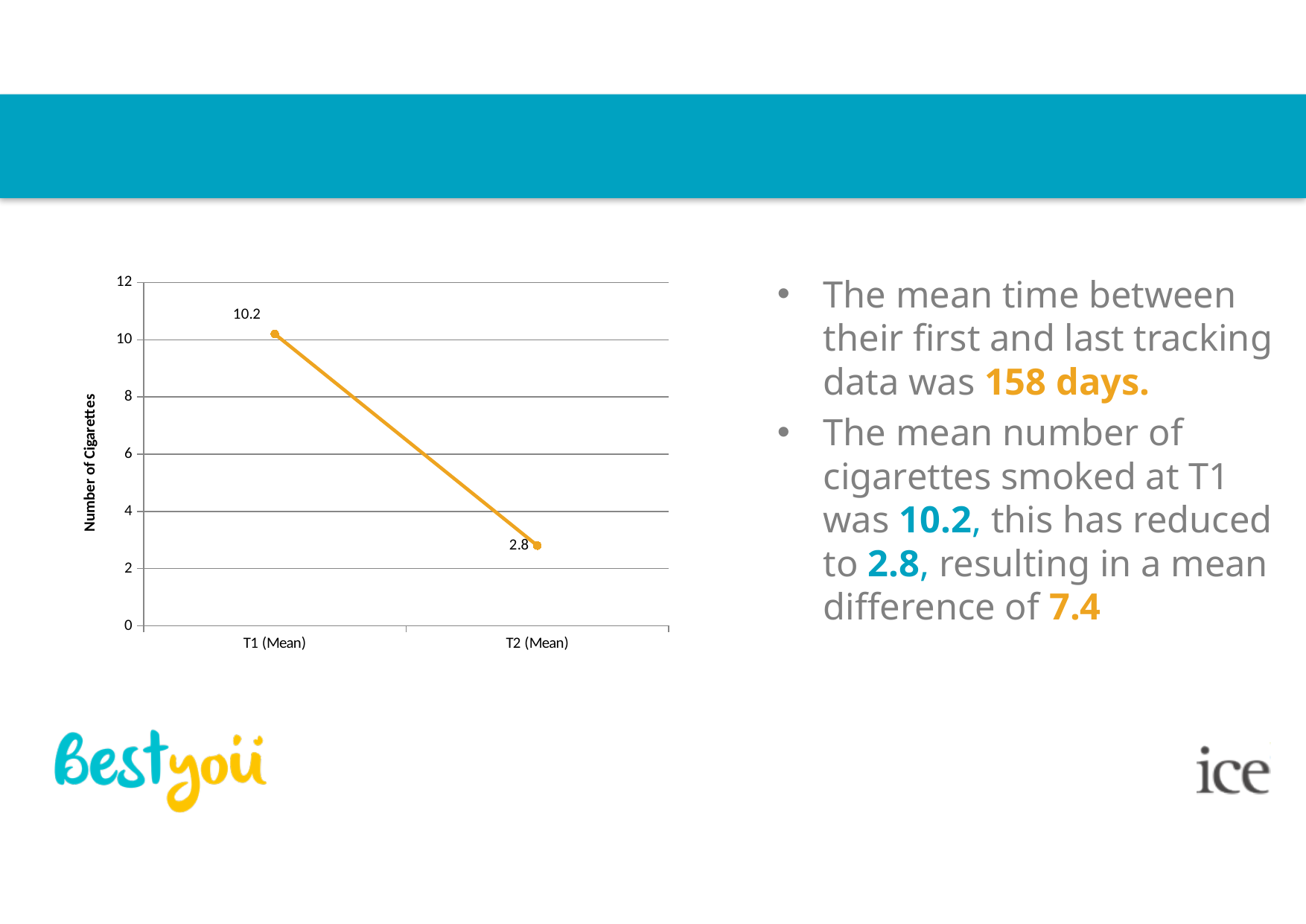
What is the label of the y axis? Number of Cigarettes What is the difference between the values for T1 (Mean) and T2 (Mean)? 7.4 Which category has the lowest value? T2 (Mean) What is the value for T1 (Mean)? 10.2 Do the values rise or fall from T1 (Mean) to T2 (Mean)? fall Is the value for T1 (Mean) greater or less than 8? greater Is the value for T2 (Mean) greater or less than 4? less Which is larger, the value for T1 (Mean) or T2 (Mean)? T1 (Mean) Which category has the highest value? T1 (Mean) What kind of chart is shown? line chart How many categories are shown on the x axis? 2 What is the value for T2 (Mean)? 2.8